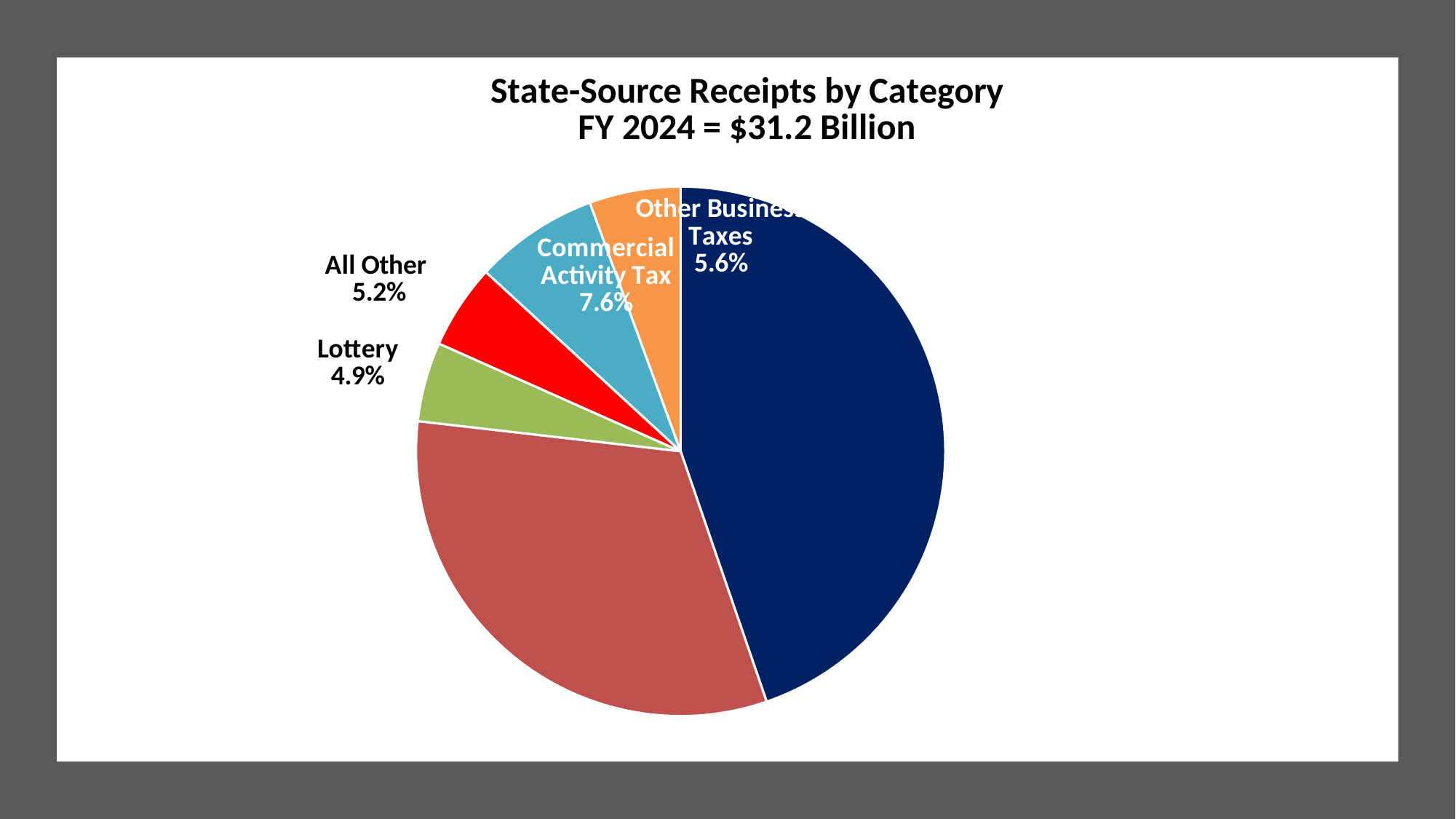
Of the slices with printed percentages, which has the smallest share? Lottery What is the title of the chart? State-Source Receipts by Category FY 2024 = $31.2 Billion What percentage is shown for Lottery? 4.9% How many slices does the pie chart have? 6 What kind of chart is shown on the slide? Pie chart What percentage is shown for Other Business Taxes? 5.6% Which is larger, the share for Commercial Activity Tax or the share for Other Business Taxes? Commercial Activity Tax What colour is the Lottery slice? Green What is the difference in percentage points between Commercial Activity Tax and Lottery? 2.7 percentage points What share of state-source receipts does the Commercial Activity Tax represent? 7.6% Which is larger, the share for All Other or the share for Lottery? All Other What percentage is shown for All Other? 5.2%